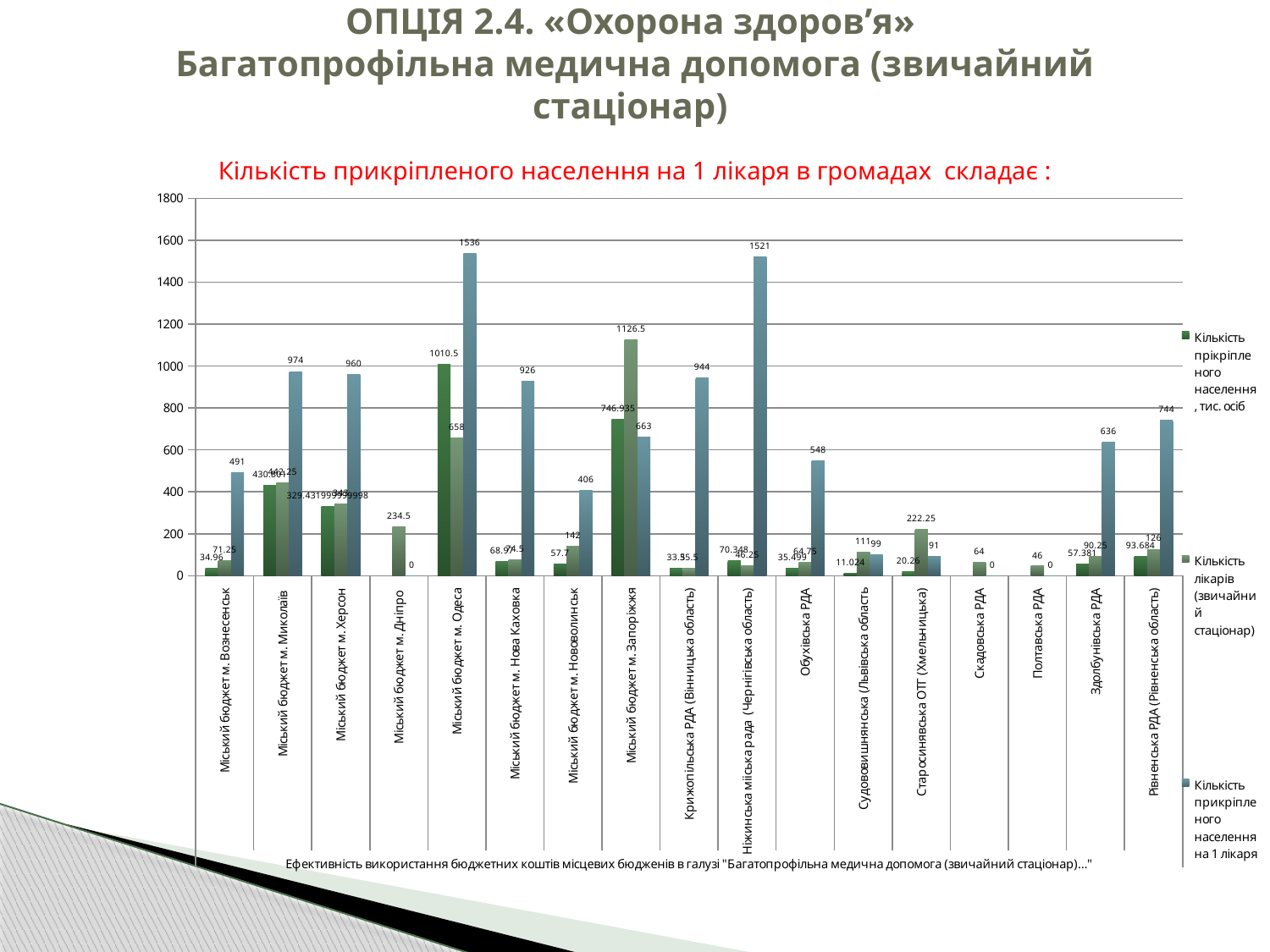
What is the value of 'Кількість лікарів (звичайний стаціонар)' for Старосинявська ОТГ (Хмельницька)? 222.25 How many series does the legend list? 3 What is the value of 'Кількість прикріпленого населення на 1 лікаря' for Ніжинська міська рада (Чернігівська область)? 1521 What kind of chart is shown on the slide? bar chart What is the value of 'Кількість прикріпленого населення на 1 лікаря' for Міський бюджет м. Одеса? 1536 What is the difference between the 'Кількість прикріпленого населення на 1 лікаря' values for Міський бюджет м. Миколаїв and Міський бюджет м. Херсон? 14 Is the 'Кількість прикріпленого населення на 1 лікаря' value for Обухівська РДА greater or less than 400? greater How many communities (categories) are shown along the x axis? 17 What is the value of 'Кількість прикріпленого населення, тис. осіб' for Міський бюджет м. Одеса? 1010.5 Which has the larger 'Кількість прикріпленого населення на 1 лікаря' value: Крижопільська РДА (Вінницька область) or Міський бюджет м. Нова Каховка? Крижопільська РДА (Вінницька область) What is the value of 'Кількість лікарів (звичайний стаціонар)' for Міський бюджет м. Запоріжжя? 1126.5 Which community has the highest value of 'Кількість прикріпленого населення на 1 лікаря'? Міський бюджет м. Одеса